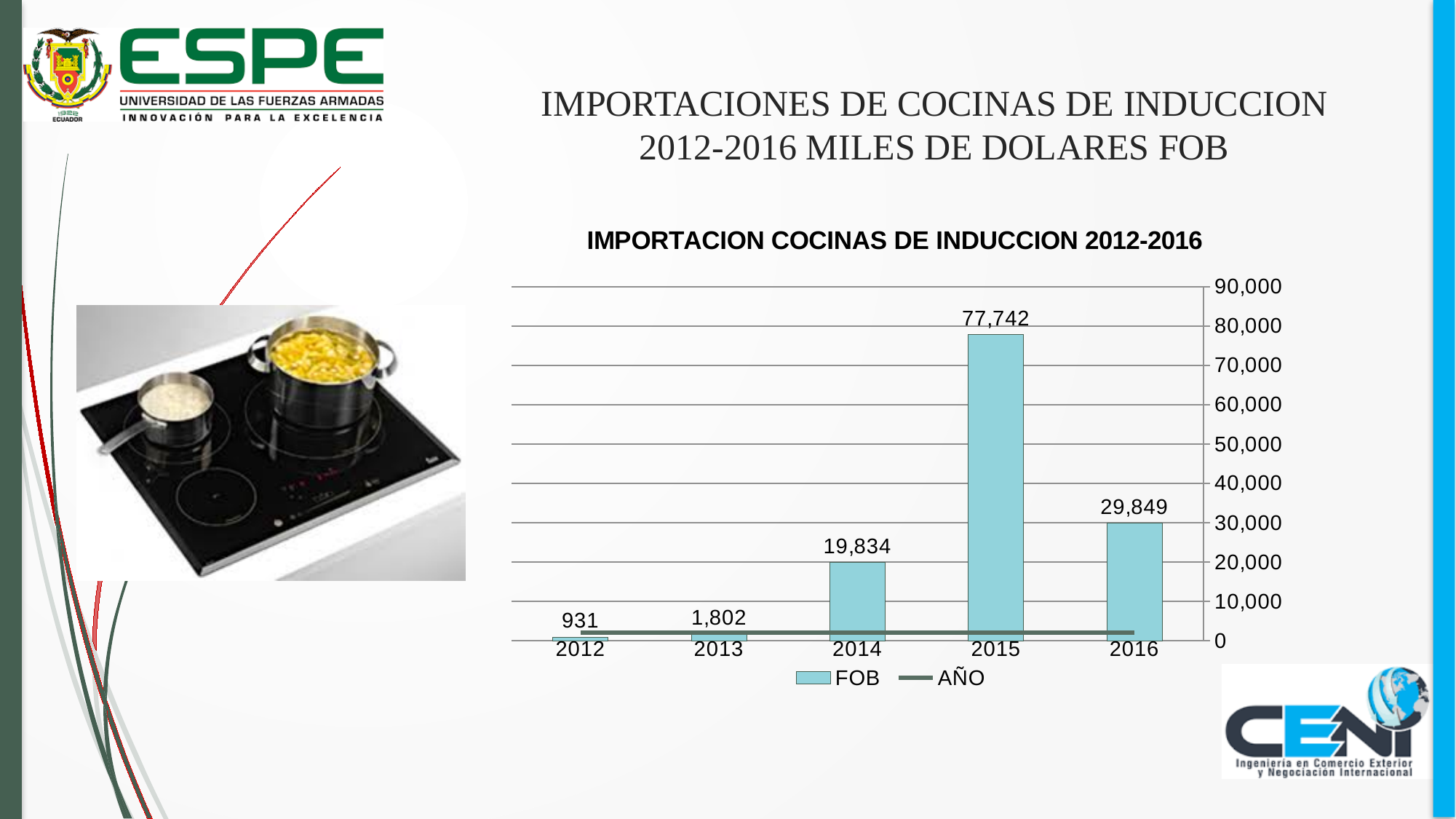
What is the FOB value for 2012? 931 How many series does the legend list? 2 What is the difference between the FOB values for 2015 and 2016? 47,893 How many years are shown on the x axis? 5 What is the title of the chart? IMPORTACION COCINAS DE INDUCCION 2012-2016 What is the FOB value for 2016? 29,849 Which year has a larger FOB value, 2013 or 2014? 2014 What is the FOB value for 2014? 19,834 What is the FOB value for 2015? 77,742 Which year has the highest FOB value? 2015 Which year has the lowest FOB value? 2012 What type of chart is used to show the FOB values? Bar chart